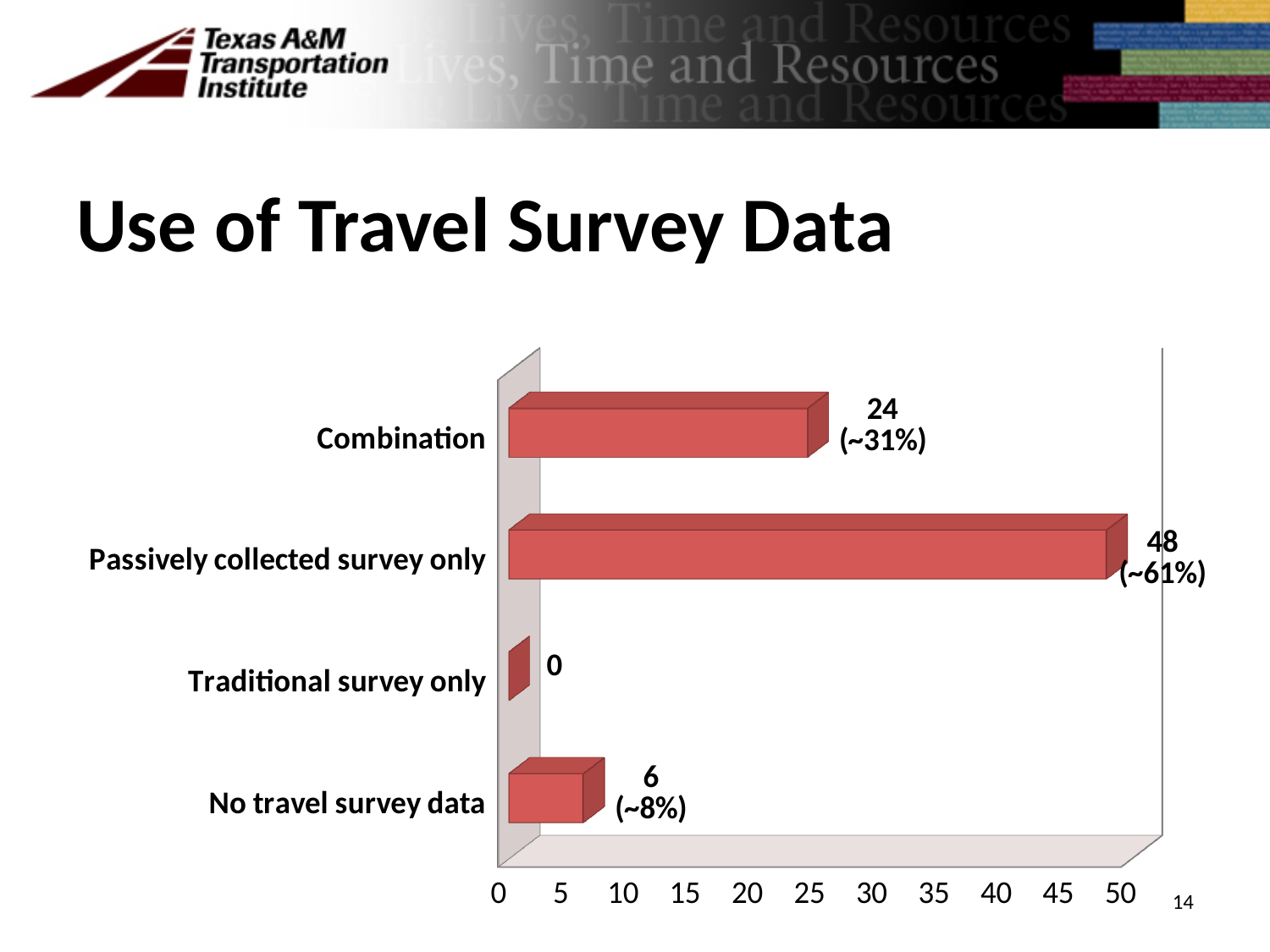
What is the value for Passively collected survey only? 48 What is the value for Combination? 24 What kind of chart is shown on the slide? Bar chart What is the value for No travel survey data? 6 Which category has the highest value? Passively collected survey only Which category has the lowest value? Traditional survey only What approximate percentage is shown next to the Passively collected survey only bar? ~61% What is the difference between the values for Passively collected survey only and Combination? 24 How many categories are shown in the chart? 4 What is the difference between the values for Combination and No travel survey data? 18 What is the value for Traditional survey only? 0 Which is larger, the value for Combination or the value for No travel survey data? Combination